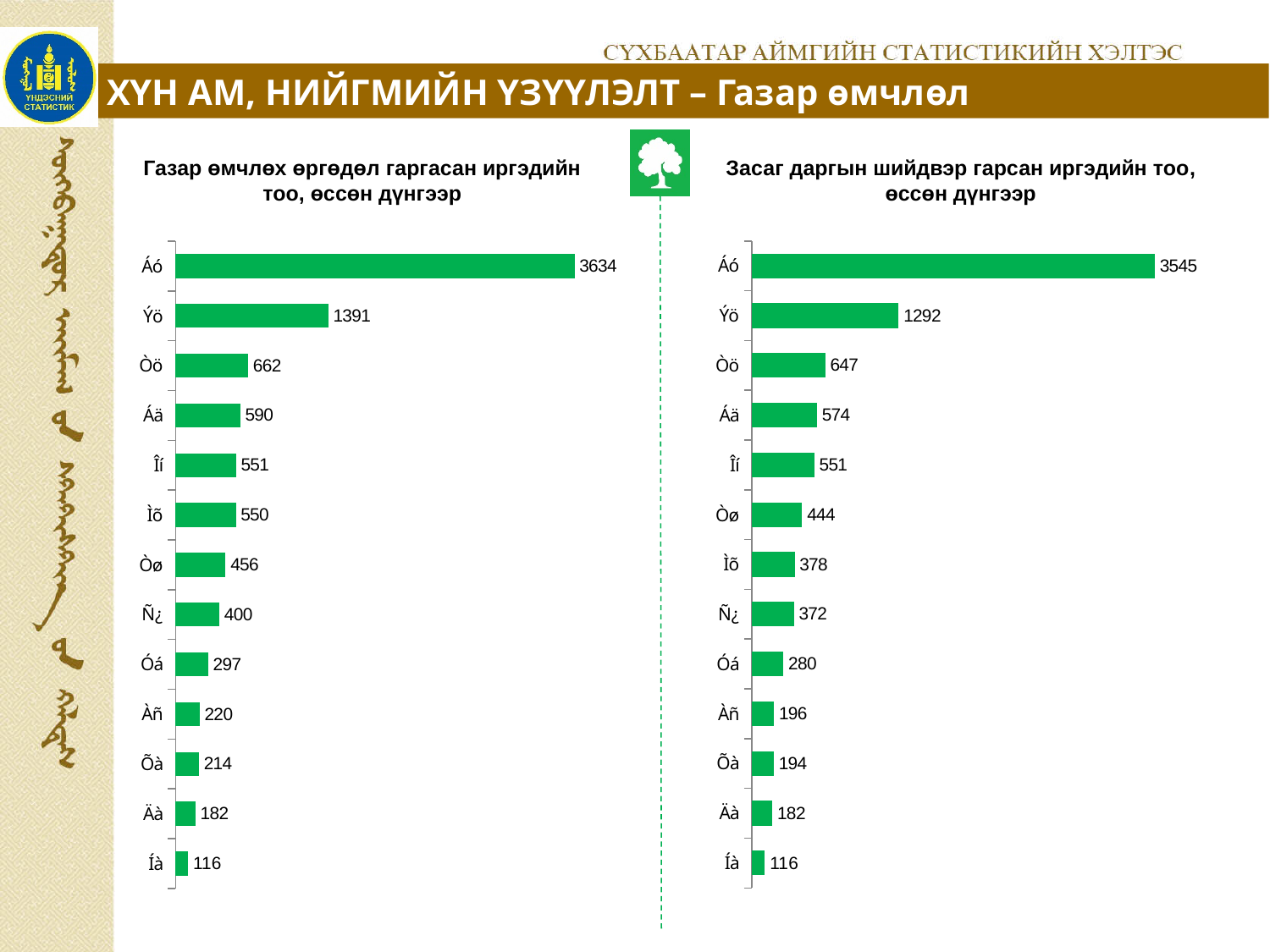
What is the title of the chart on the left side of the slide? Газар өмчлөх өргөдөл гаргасан иргэдийн тоо, өссөн дүнгээр What type of chart is used on the right side of the slide? Bar chart In the right chart (Засаг даргын шийдвэр гарсан иргэдийн тоо, өссөн дүнгээр), what is the value of the second bar, labelled Ýö? 1292 In the left chart, which category has the lowest value? Íà In the left chart, what is the difference between the values for Áó and Ýö? 2243 In the left chart, what is the value of the bar labelled Òø? 456 In the right chart, which category has the highest value? Áó In the right chart, what is the difference between the values for Òö and Áä? 73 Which is larger: the value for Áó in the left chart or the value for Áó in the right chart? The left chart (3634) How many categories (bars) does the left chart show? 13 In the left chart (Газар өмчлөх өргөдөл гаргасан иргэдийн тоо, өссөн дүнгээр), what is the value of the top bar, labelled Áó? 3634 How many categories (bars) does the right chart show? 13